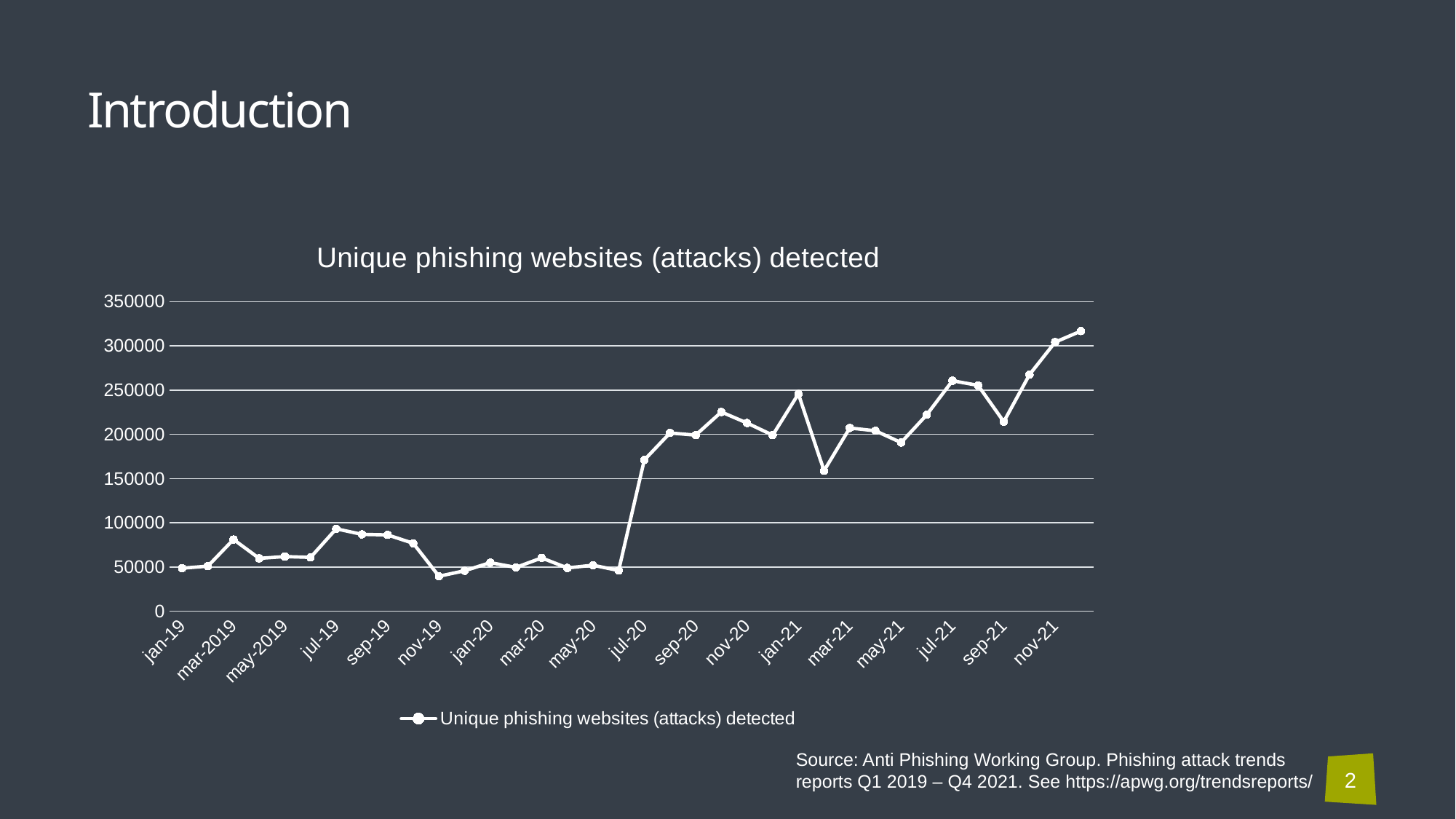
What kind of chart is shown on the slide? line chart How many series does the legend list? 1 Which labelled month has the lowest value on the chart? nov-19 Which is larger, the value for jul-19 or the value for jul-20? jul-20 Is the value for jul-20 greater or less than 150000? greater Is the value for jul-19 greater or less than 100000? less Do the values generally rise or fall from jan-19 to nov-21? rise What is the highest value shown on the vertical axis? 350000 Is the value for sep-21 greater or less than 250000? less What is the title of the chart? Unique phishing websites (attacks) detected